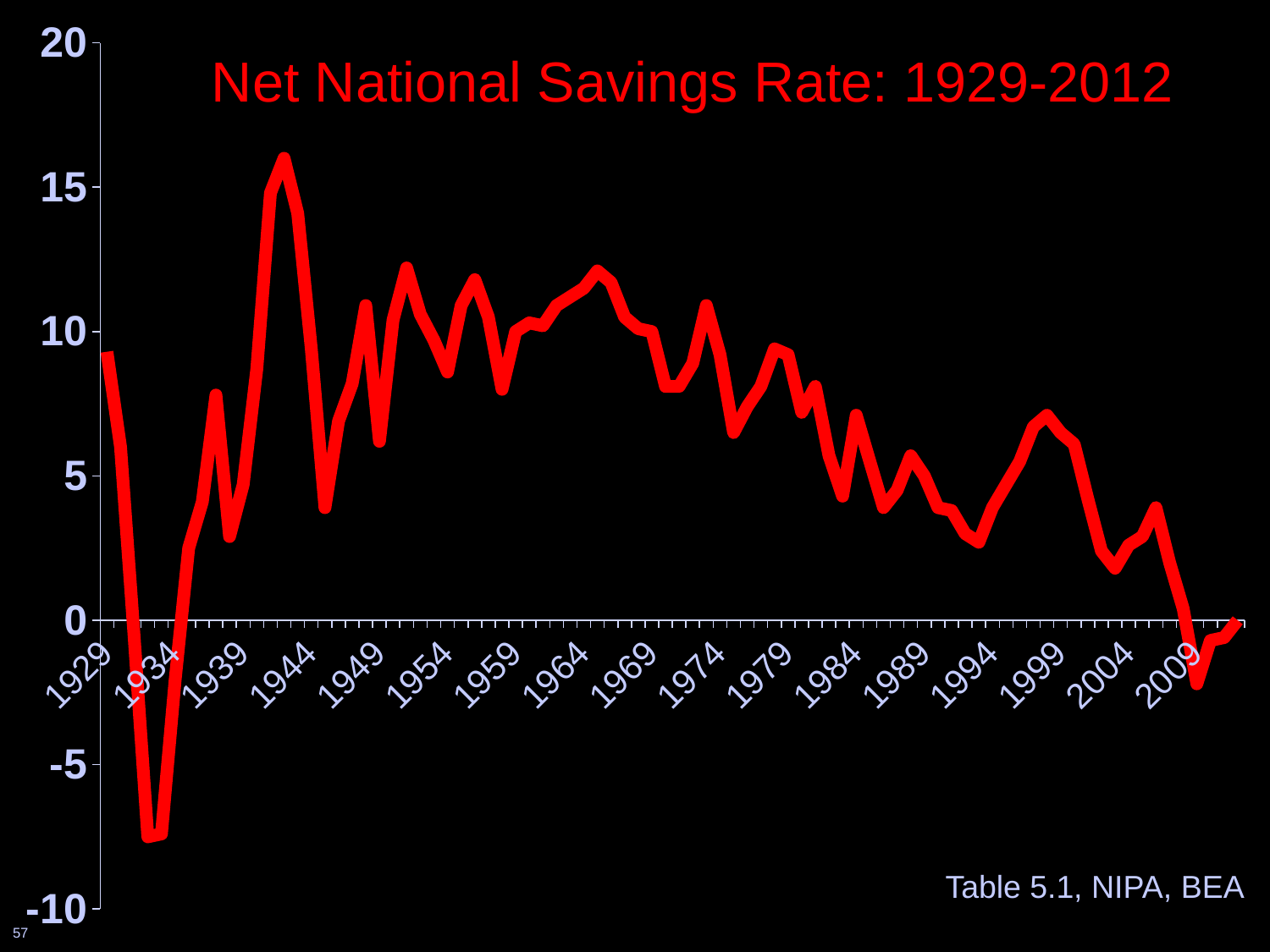
Is the value for 2009 greater or less than 0? less What source is cited at the bottom right of the chart? Table 5.1, NIPA, BEA Is the highest value reached by the line greater or less than 15? greater Which is larger, the value for 1944 or the value for 1984? 1944 Does the line generally rise or fall between 1964 and 2009? fall What kind of chart is shown on the slide? line chart Is the value for 1934 greater or less than -5? greater How many year labels are shown on the x axis? 17 What is the title of the chart? Net National Savings Rate: 1929-2012